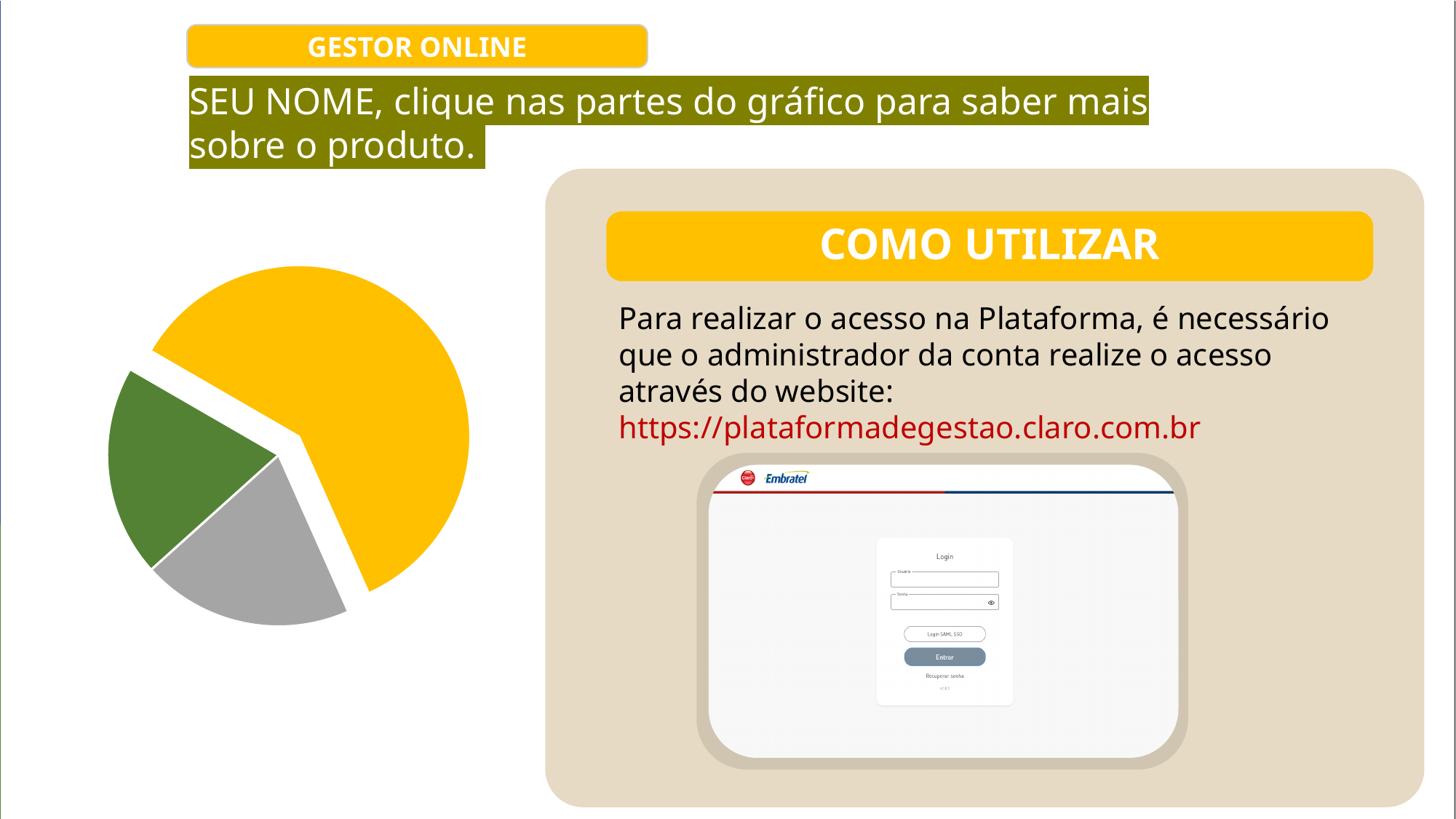
Does the pie chart display a legend? No Which slice of the pie chart is pulled out (exploded) from the rest? the yellow slice Which is larger in the pie chart, the yellow slice or the green slice? the yellow slice Which is larger in the pie chart, the yellow slice or the gray slice? the yellow slice What kind of chart is shown on the left of the slide? pie chart How many slices does the pie chart have? 3 Which slice of the pie chart is the largest? the yellow slice